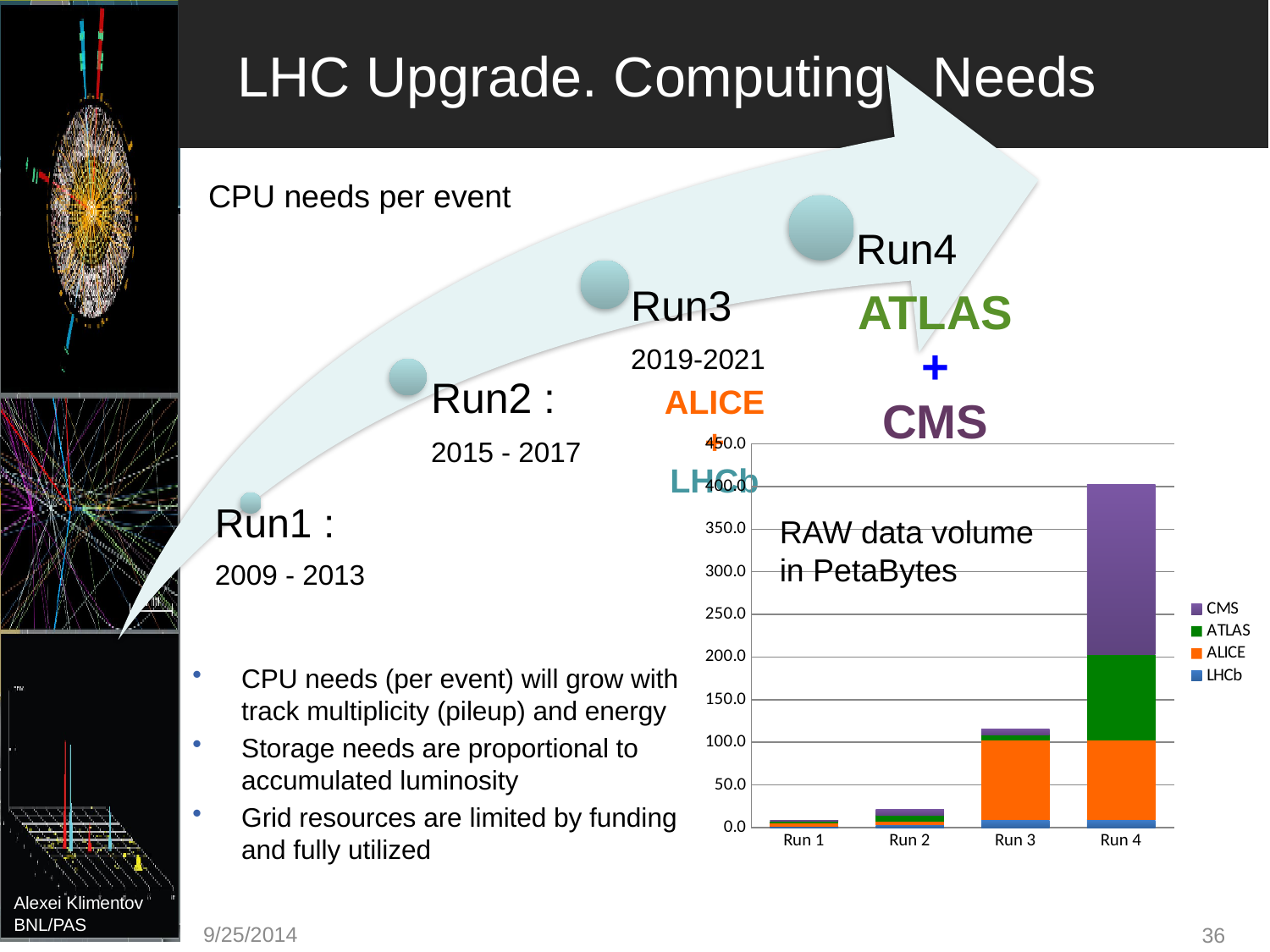
Which run has the lowest total RAW data volume in the chart? Run 1 Which has a larger total RAW data volume, Run 3 or Run 4? Run 4 What unit does the chart's label say the RAW data volume is measured in? PetaBytes Do the total RAW data volumes rise or fall from Run 1 to Run 4? rise How many categories (runs) are shown on the x axis of the chart? 4 Which run has the highest total RAW data volume in the chart? Run 4 How many series does the chart's legend list? 4 Is the total value for Run 3 greater or less than 100.0? greater Is the total value for Run 2 greater or less than 50.0? less What kind of chart is shown on the slide? stacked bar chart Is the total value for Run 4 greater or less than 350.0? greater Which series is shown in purple in the chart's legend? CMS